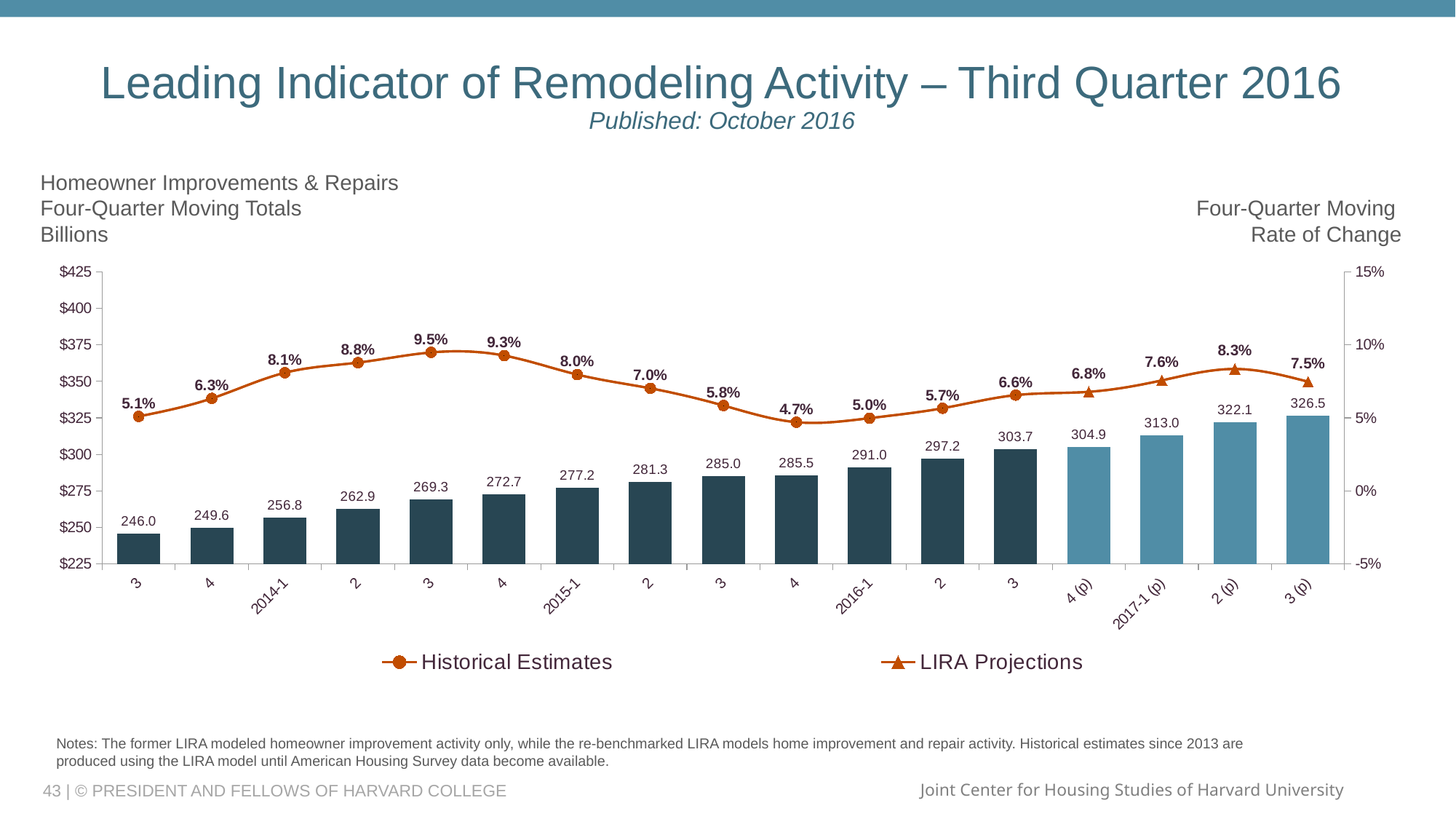
Which period has the highest rate of change on the line? 2014-3 (9.5%) Which period has the lowest rate of change on the line? 2015-4 (4.7%) What rate of change is shown for 3 (p), the last point on the chart? 7.5% What is the difference between the four-quarter moving totals for 2016-1 and 2015-1? 13.8 What are the two series named in the legend? Historical Estimates and LIRA Projections Is the four-quarter moving total for 2016-1 greater or less than $300? less What is the projected four-quarter moving total for 2017-1 (p)? 313.0 Do the four-quarter moving totals (bars) rise or fall from left to right across the chart? rise Which is larger, the rate of change for 2015-1 or for 2017-1 (p)? 2015-1 What rate of change is shown for 2014-1? 8.1% How many series does the legend list? 2 What is the four-quarter moving total (in billions) shown for 2016-1? 291.0